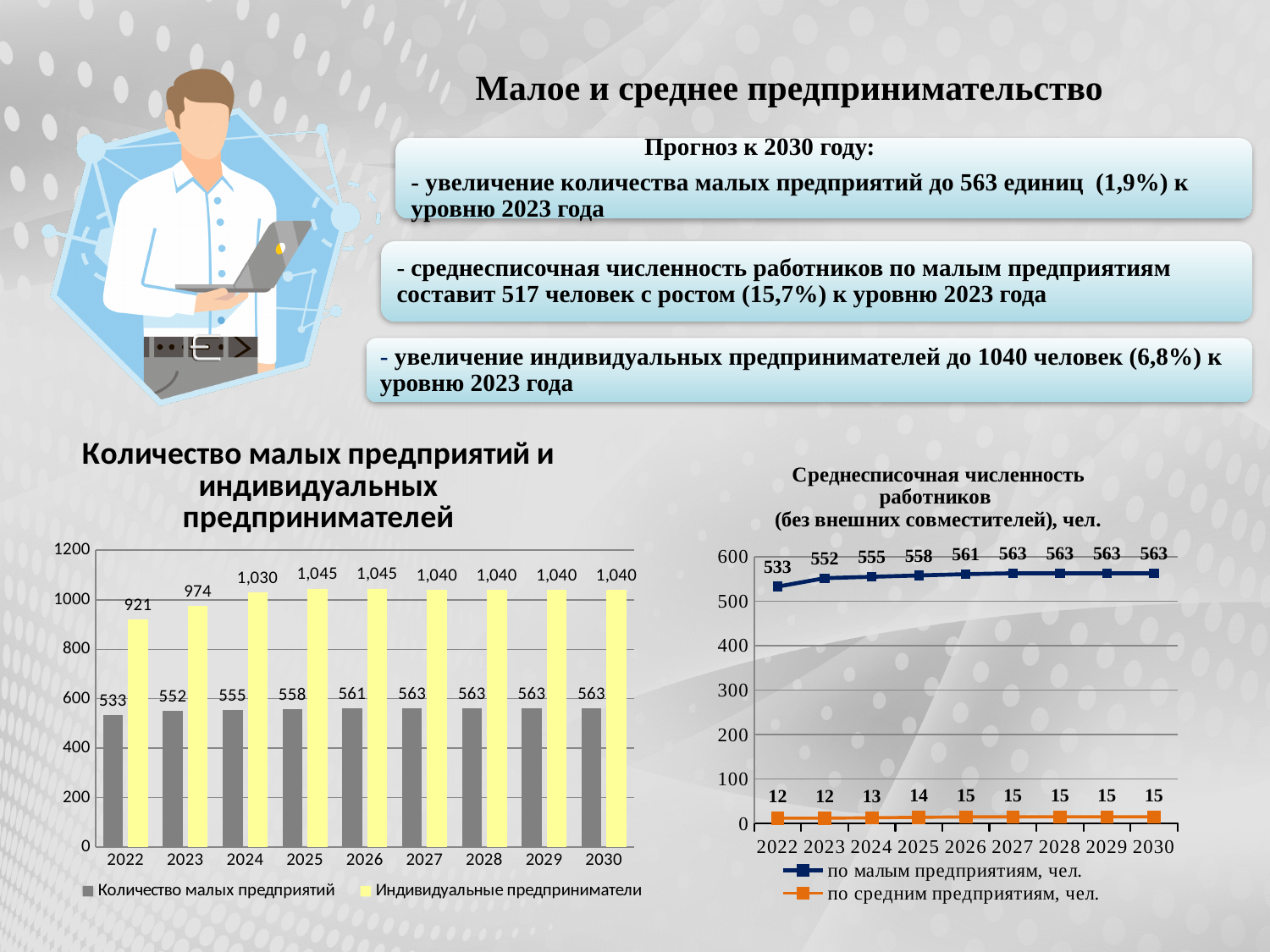
In the right chart 'Среднесписочная численность работников', which series is larger in 2030: 'по малым предприятиям, чел.' or 'по средним предприятиям, чел.'? по малым предприятиям, чел. In the right chart 'Среднесписочная численность работников', does the series 'по малым предприятиям, чел.' rise or fall from 2022 to 2027? rise What kind of chart is the right chart 'Среднесписочная численность работников'? line chart In the left chart 'Количество малых предприятий и индивидуальных предпринимателей', what is the difference between 'Индивидуальные предприниматели' and 'Количество малых предприятий' in 2023? 422 In the left chart 'Количество малых предприятий и индивидуальных предпринимателей', what is the value for 'Индивидуальные предприниматели' in 2024? 1,030 In the left chart 'Количество малых предприятий и индивидуальных предпринимателей', in which year is 'Индивидуальные предприниматели' lowest? 2022 In the right chart 'Среднесписочная численность работников', what is the value for 'по средним предприятиям, чел.' in 2025? 14 In the right chart 'Среднесписочная численность работников', how many series does the legend list? 2 In the left chart 'Количество малых предприятий и индивидуальных предпринимателей', how many years are shown on the x axis? 9 In the right chart 'Среднесписочная численность работников', what is the value for 'по малым предприятиям, чел.' in 2026? 561 In the left chart 'Количество малых предприятий и индивидуальных предпринимателей', what is the value for 'Количество малых предприятий' in 2022? 533 What kind of chart is the left chart 'Количество малых предприятий и индивидуальных предпринимателей'? bar chart